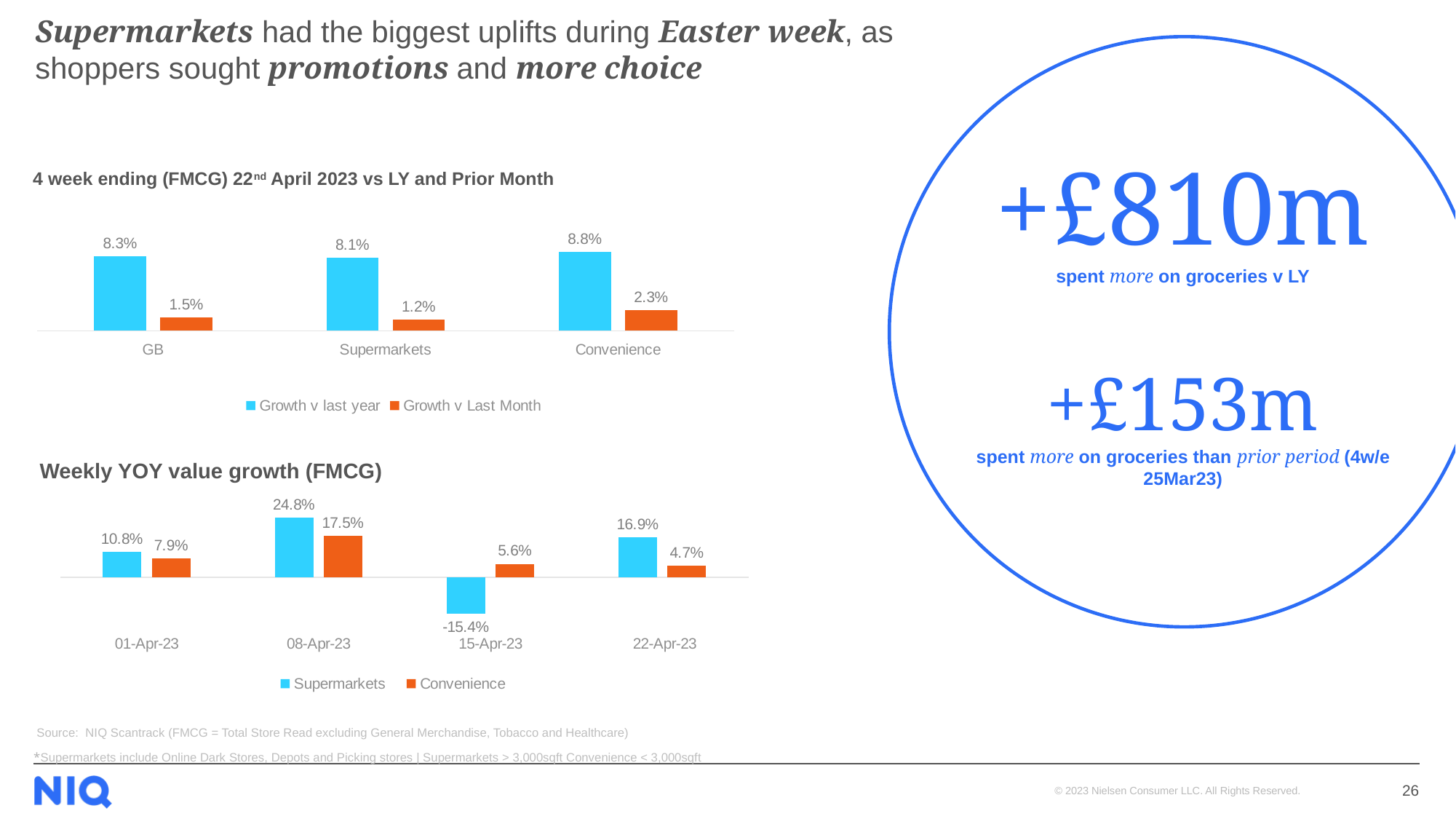
In the '4 week ending (FMCG) 22nd April 2023 vs LY and Prior Month' chart, what is the difference between Growth v last year and Growth v Last Month for GB? 6.8% How many series does the legend of the '4 week ending (FMCG) 22nd April 2023 vs LY and Prior Month' chart list? 2 In the '4 week ending (FMCG) 22nd April 2023 vs LY and Prior Month' chart, what is the Growth v last year value for Supermarkets? 8.1% In the '4 week ending (FMCG) 22nd April 2023 vs LY and Prior Month' chart, which category has the highest Growth v last year? Convenience In the '4 week ending (FMCG) 22nd April 2023 vs LY and Prior Month' chart, which category has the lowest Growth v Last Month? Supermarkets In the 'Weekly YOY value growth (FMCG)' chart, what is the Supermarkets value for 08-Apr-23? 24.8% What kind of chart is the 'Weekly YOY value growth (FMCG)' chart? Bar chart In the 'Weekly YOY value growth (FMCG)' chart, which is larger for 15-Apr-23: Supermarkets or Convenience? Convenience In the '4 week ending (FMCG) 22nd April 2023 vs LY and Prior Month' chart, what is the Growth v Last Month value for Convenience? 2.3% In the 'Weekly YOY value growth (FMCG)' chart, which week has the lowest Supermarkets value? 15-Apr-23 In the 'Weekly YOY value growth (FMCG)' chart, what is the Convenience value for 22-Apr-23? 4.7% How many weeks are shown on the x axis of the 'Weekly YOY value growth (FMCG)' chart? 4